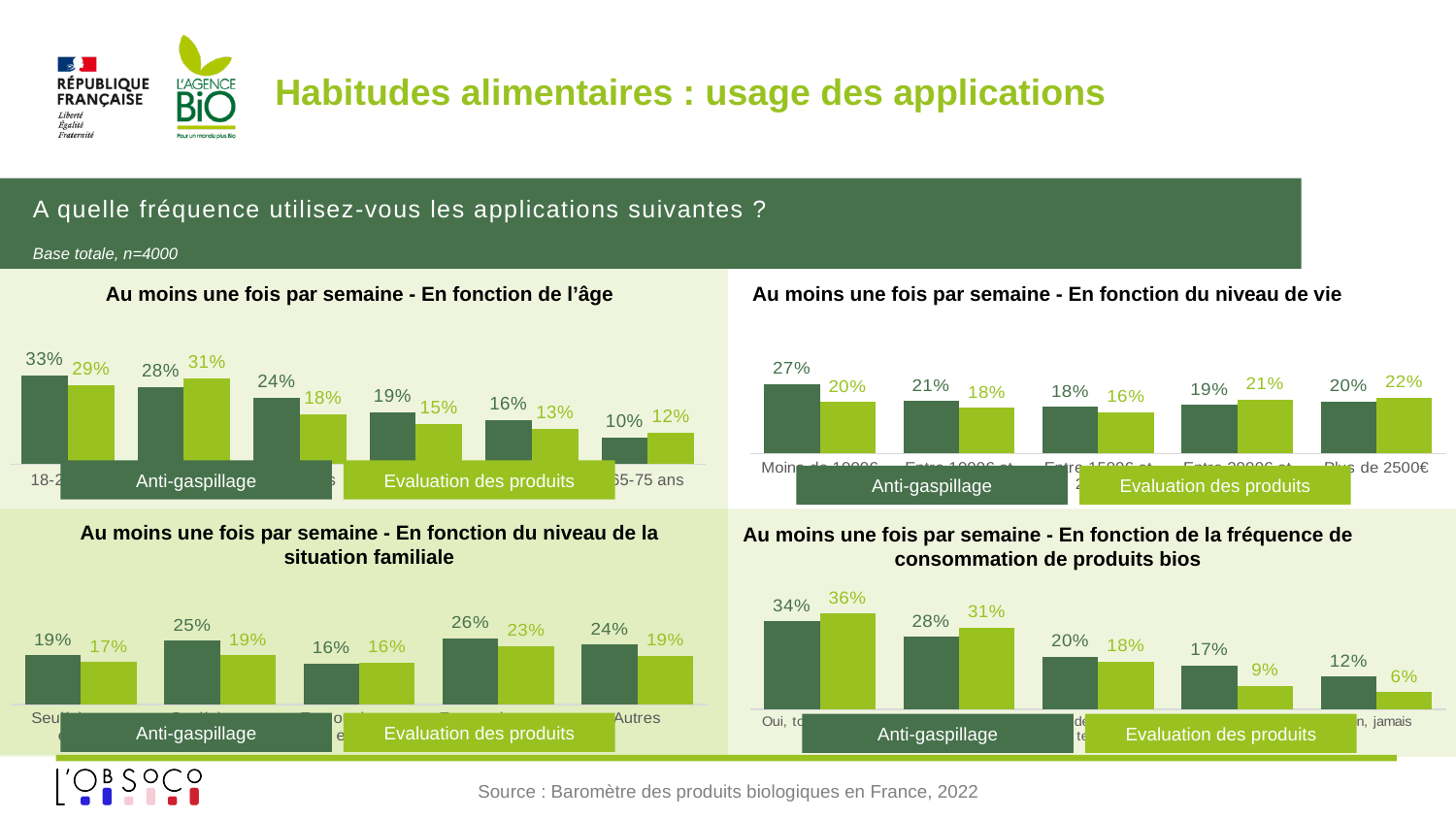
In the chart 'Au moins une fois par semaine - En fonction du niveau de vie', what is the value for Evaluation des produits in the 'Plus de 2500€' category? 22% How many series does the legend list in the chart 'Au moins une fois par semaine - En fonction du niveau de vie'? 2 In the chart 'Au moins une fois par semaine - En fonction de l'âge', what is the highest value shown for Anti-gaspillage? 33% In the chart 'Au moins une fois par semaine - En fonction de la fréquence de consommation de produits bios', what is the difference between the highest and lowest Anti-gaspillage values? 22 percentage points In the chart 'Au moins une fois par semaine - En fonction du niveau de la situation familiale', which series has the larger value for 'Autres': Anti-gaspillage or Evaluation des produits? Anti-gaspillage In the chart 'Au moins une fois par semaine - En fonction du niveau de vie', what is the value for Anti-gaspillage in the 'Plus de 2500€' category? 20% In the chart 'Au moins une fois par semaine - En fonction du niveau de la situation familiale', what is the Anti-gaspillage value for the 'Autres' category? 24% In the chart 'Au moins une fois par semaine - En fonction de l'âge', do the Anti-gaspillage values rise or fall from the youngest to the oldest age group? fall How many categories are shown in the chart 'Au moins une fois par semaine - En fonction du niveau de vie'? 5 What kind of chart is 'Au moins une fois par semaine - En fonction de la fréquence de consommation de produits bios'? bar chart In the chart 'Au moins une fois par semaine - En fonction de la fréquence de consommation de produits bios', what is the difference between the Evaluation des produits and Anti-gaspillage values in the first category? 2 percentage points In the chart 'Au moins une fois par semaine - En fonction de la fréquence de consommation de produits bios', what is the lowest value shown for Evaluation des produits? 6%